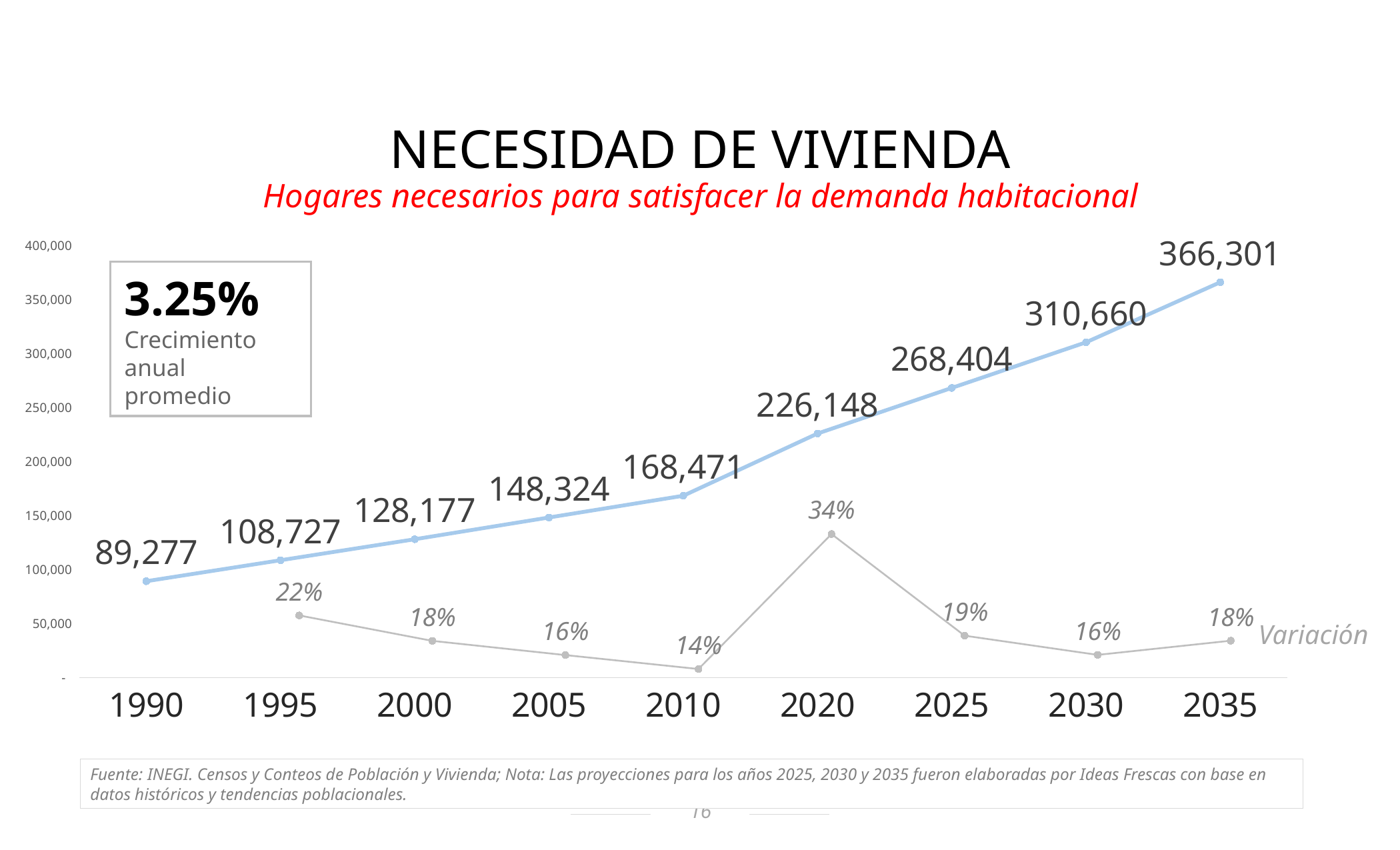
Which year has the lowest Variación value? 2010 Which is larger, the value for 2005 or the value for 2010? 2010 Which year has the highest value on the main line? 2035 What is the difference between the values for 2035 and 2030? 55,641 What is the value for 1990? 89,277 How many years are shown on the x axis? 9 What is the value for 2020? 226,148 What is the Variación value for 2020? 34% What average annual growth rate is shown in the box on the chart? 3.25% What is the Variación value for 2010? 14% What kind of chart is this? line chart Do the values on the main line rise or fall from 1990 to 2035? rise